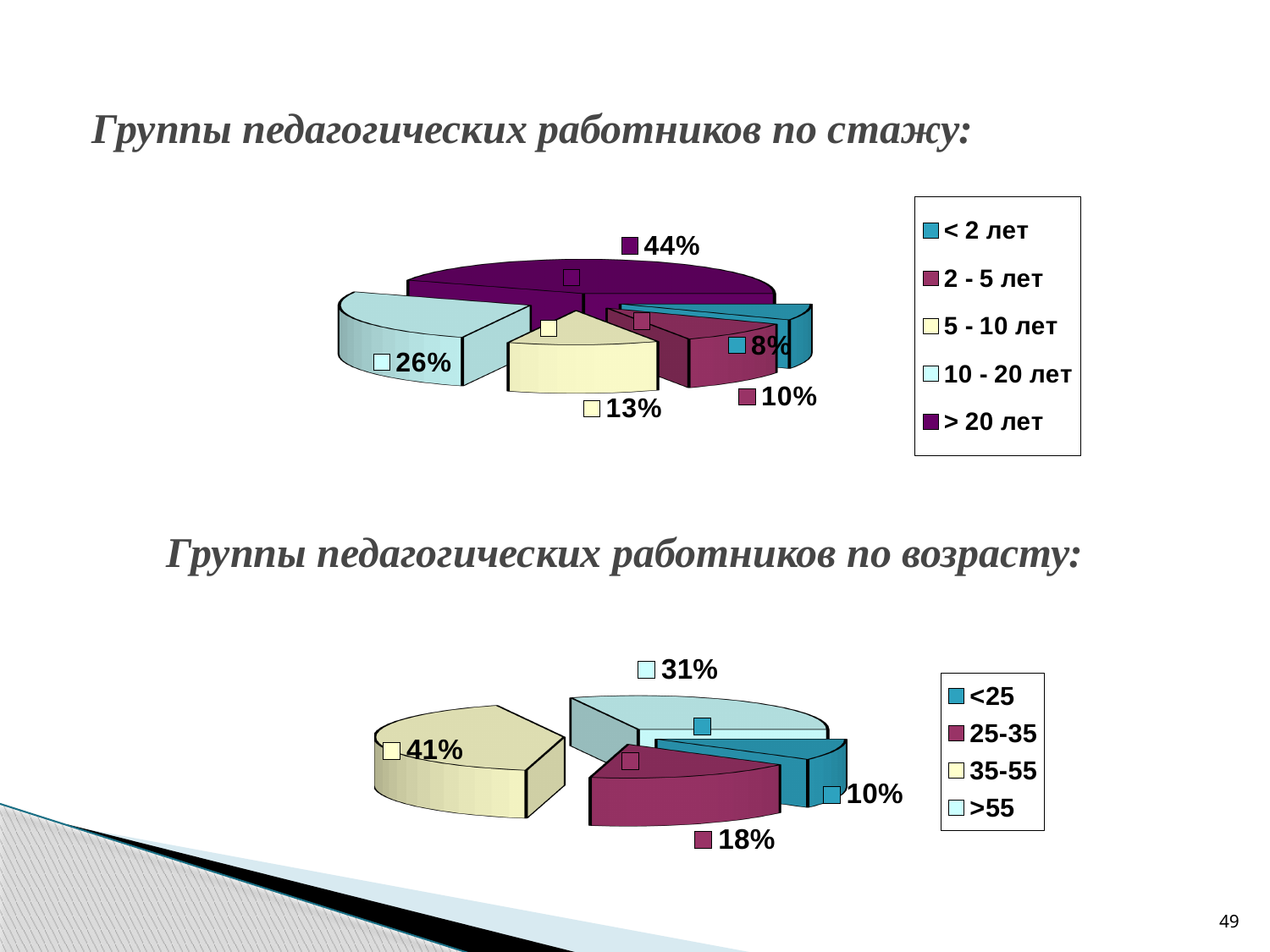
In the bottom chart (Группы педагогических работников по возрасту), what is the share of the 35-55 age group? 41% In the bottom chart (Группы педагогических работников по возрасту), what is the share of the >55 age group? 31% In the bottom chart (Группы педагогических работников по возрасту), which is larger: the share of 25-35 or the share of >55? >55 In the top chart (Группы педагогических работников по стажу), what share of teachers have more than 20 years of experience (> 20 лет)? 44% In the top chart (Группы педагогических работников по стажу), which experience group has the smallest share? < 2 лет In the top chart (Группы педагогических работников по стажу), how many experience groups are shown in the legend? 5 What type of chart is used in the bottom chart (Группы педагогических работников по возрасту)? pie chart In the bottom chart (Группы педагогических работников по возрасту), which age group has the smallest share? <25 In the bottom chart (Группы педагогических работников по возрасту), what is the difference between the 35-55 share and the 25-35 share? 23% In the top chart (Группы педагогических работников по стажу), what is the value for the 10 - 20 лет group? 26% In the top chart (Группы педагогических работников по стажу), what is the difference between the 10 - 20 лет share and the 5 - 10 лет share? 13% In the top chart (Группы педагогических работников по стажу), which experience group has the largest share? > 20 лет